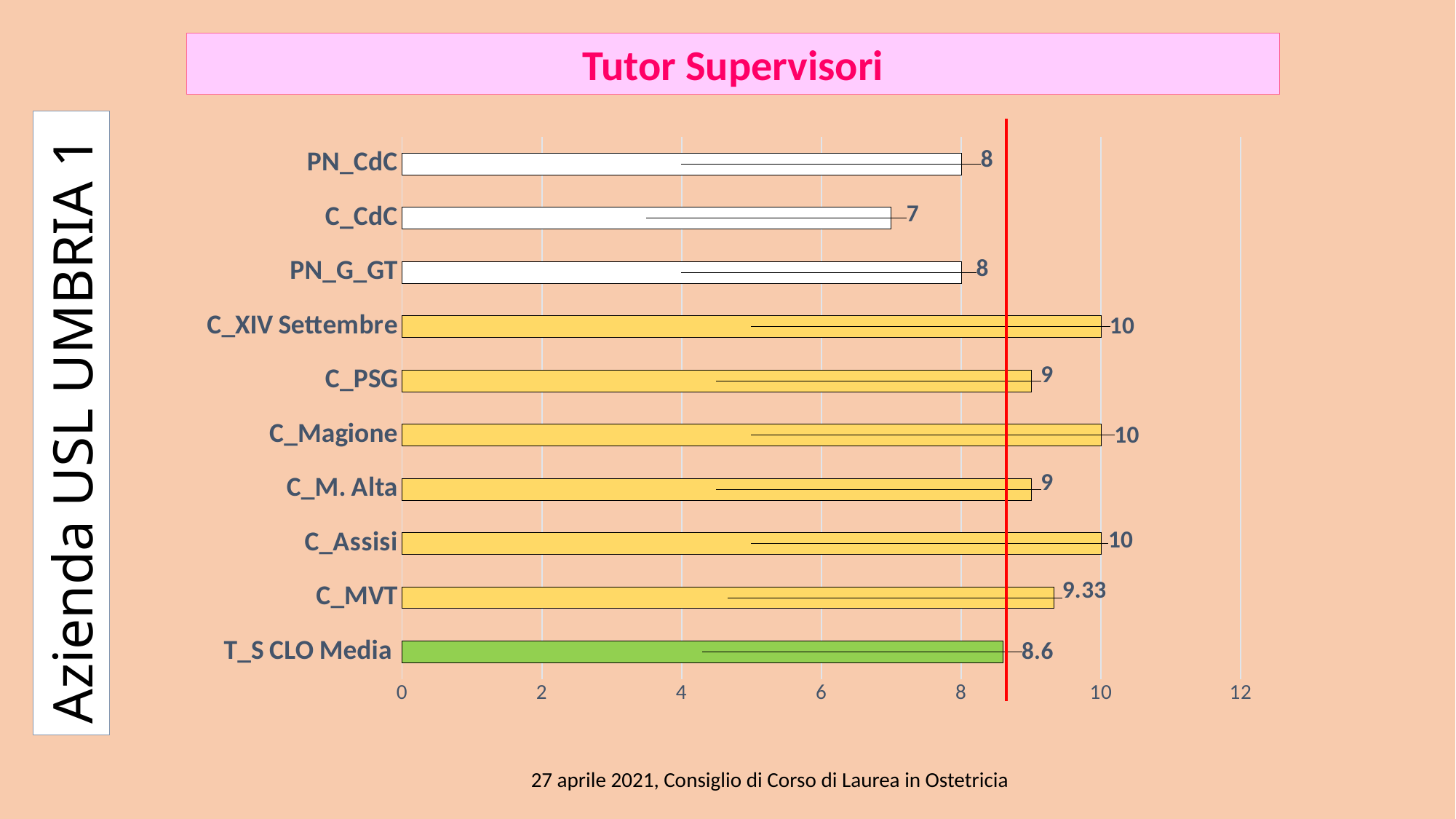
What is the difference between the values for C_MVT and T_S CLO Media? 0.73 What is the value for PN_G_GT? 8 What is the value for C_CdC? 7 Is the value for C_MVT greater or less than 8? greater What is the value for C_MVT? 9.33 What kind of chart is shown on the slide? bar chart Which category has the lowest value? C_CdC What is the value for T_S CLO Media? 8.6 What is the difference between the values for C_XIV Settembre and C_CdC? 3 How many categories are shown in the chart? 10 What is the title of the chart? Tutor Supervisori Which is larger, the value for C_PSG or the value for PN_CdC? C_PSG